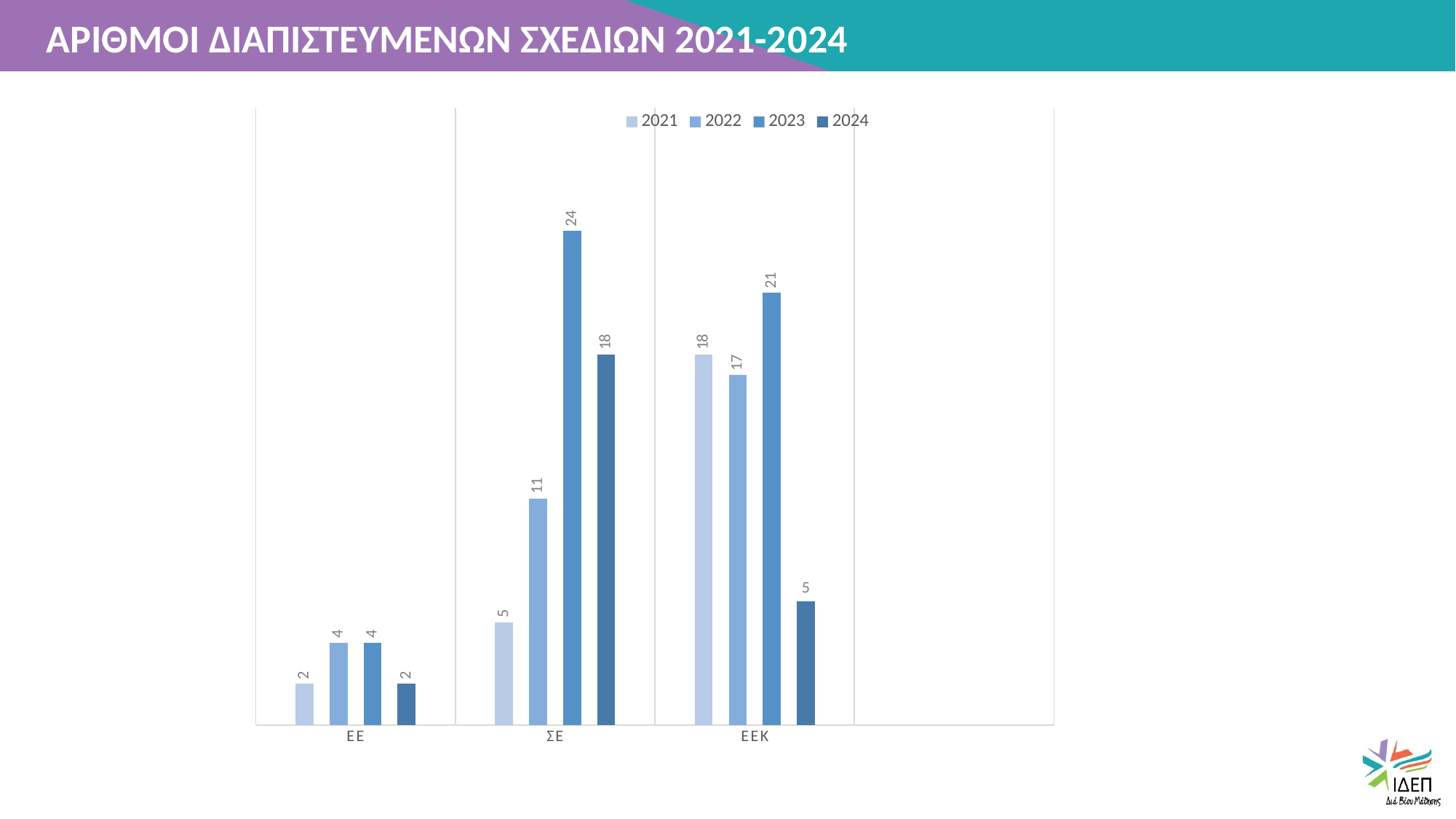
How many categories are shown on the x axis? 3 What is the title of the slide? ΑΡΙΘΜΟΙ ΔΙΑΠΙΣΤΕΥΜΕΝΩΝ ΣΧΕΔΙΩΝ 2021-2024 What kind of chart is shown on the slide? Bar chart How many series does the legend list? 4 What is the value for ΣΕ in 2023? 24 What is the value for ΕΕΚ in 2022? 17 Which category has the highest value in 2023? ΣΕ What is the value for ΕΕ in 2021? 2 What is the difference between the 2023 and 2024 values for ΣΕ? 6 Which is larger: the 2021 value for ΕΕΚ or the 2021 value for ΣΕ? ΕΕΚ Which category has the lowest value in 2022? ΕΕ What is the value for ΕΕΚ in 2024? 5